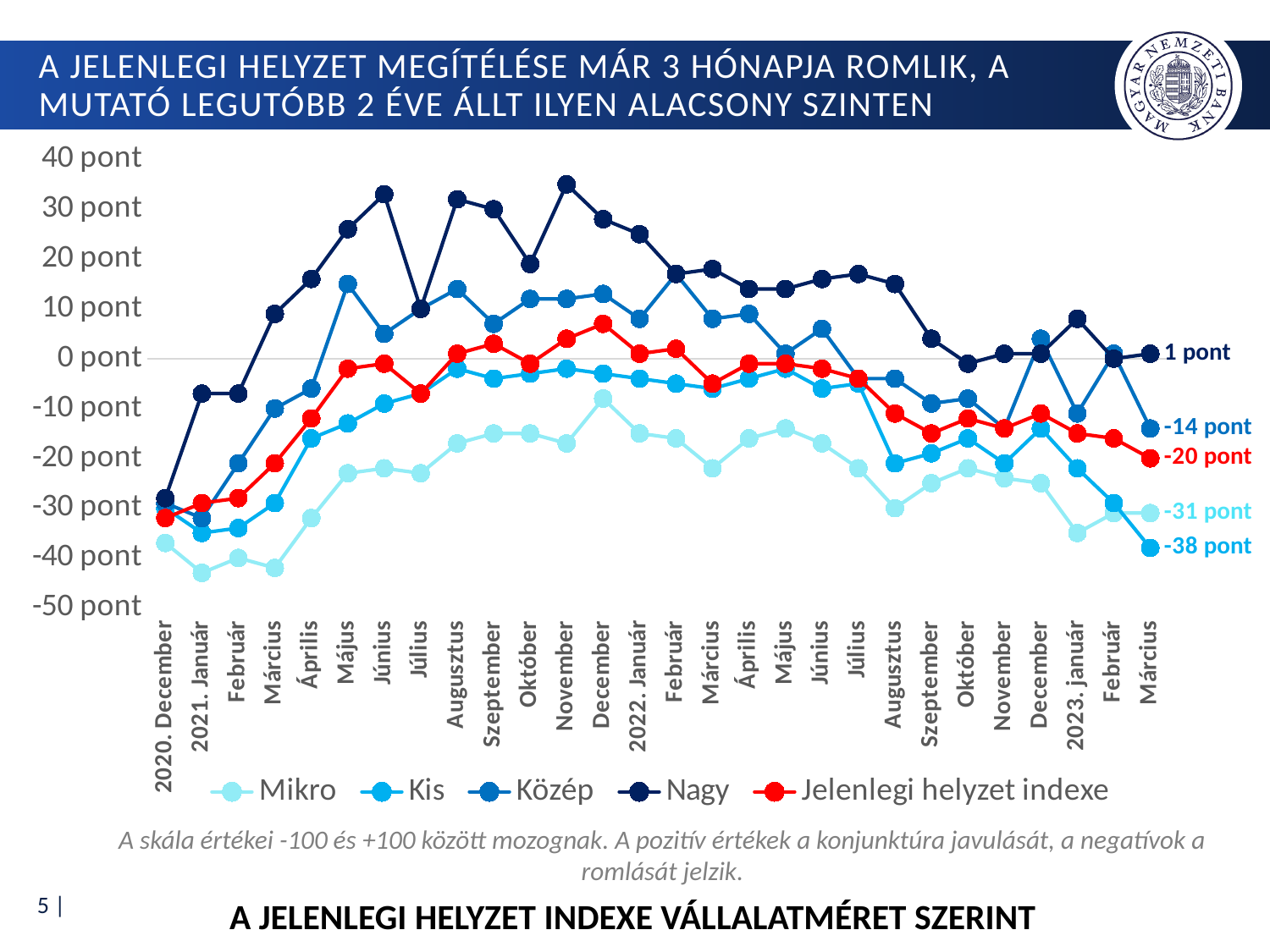
Is the value of the Nagy series in 2021 Június greater or less than 30 pont? greater How many series does the legend list? 5 What is the value of the Jelenlegi helyzet indexe series in 2023 Március, as labelled on the chart? -20 pont Which series has the highest value in 2023 Március? Nagy Does the Jelenlegi helyzet indexe series rise or fall from 2022 December to 2023 Március? fall What is the value of the Nagy series in 2023 Március, as labelled on the chart? 1 pont What is the value of the Kis series in 2023 Március, as labelled on the chart? -38 pont Which series has the lowest value in 2023 Március? Kis What is the difference between the Nagy and Kis values in 2023 Március? 39 pont What is the value of the Mikro series in 2023 Március, as labelled on the chart? -31 pont What kind of chart is shown on the slide? Line chart What is the value of the Közép series in 2023 Március, as labelled on the chart? -14 pont